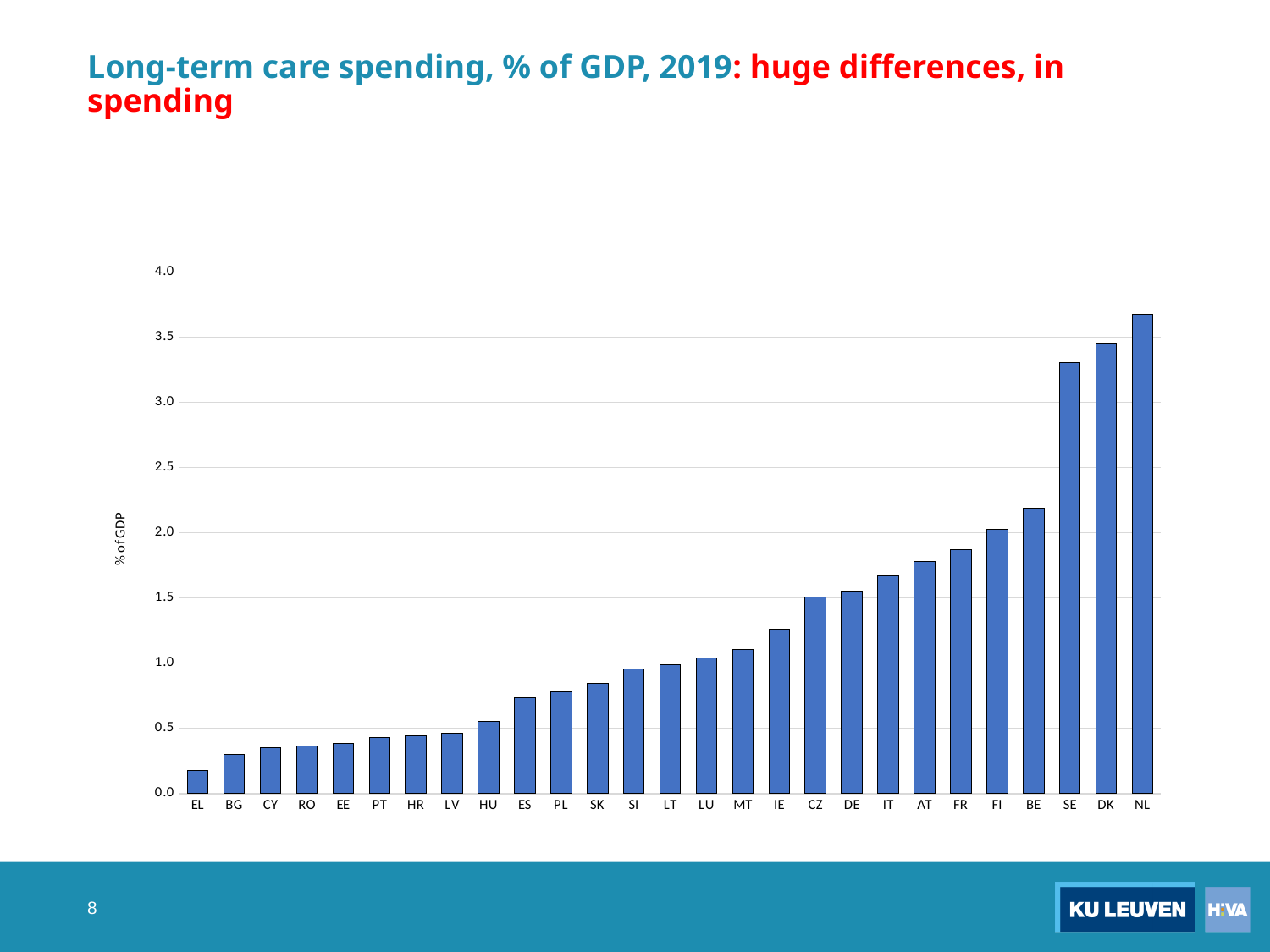
Is the value for IT greater or less than 1.5? greater What kind of chart is shown on the slide? bar chart Which country has the lowest long-term care spending as % of GDP? EL How many countries are shown on the x axis? 27 What is the label of the vertical axis? % of GDP Is the value for ES greater or less than 1.0? less Is the value for NL greater or less than 3.5? greater Which country has the highest long-term care spending as % of GDP? NL Which has a higher value, BE or IE? BE Do the values rise or fall from left to right along the x axis? rise